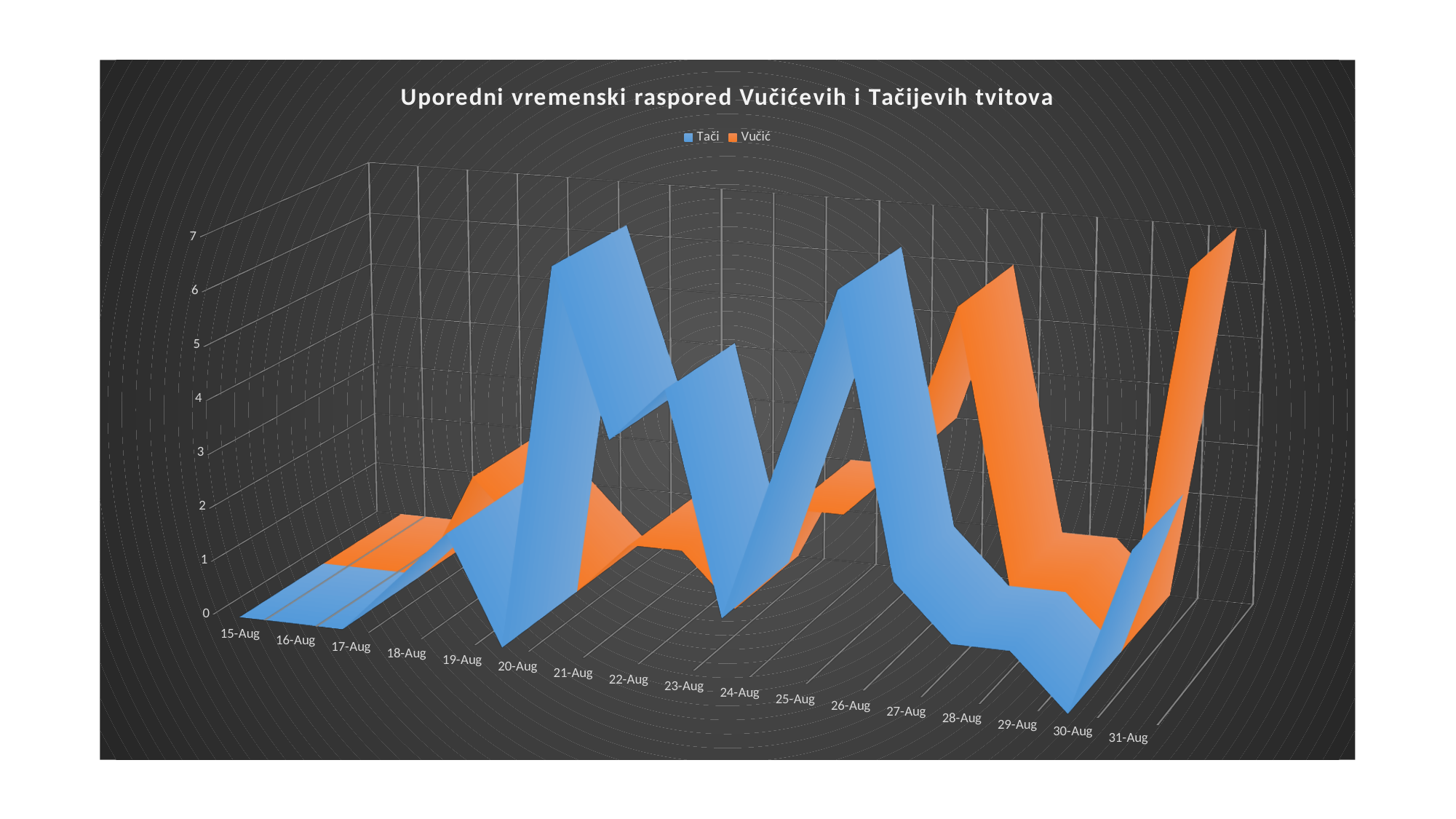
On which date does the Vučić series reach its highest value? 31-Aug Which series is shown in orange? Vučić How many dates are shown on the x axis? 17 Which series has the higher value on 21-Aug, Tači or Vučić? Tači Which series has the higher value on 31-Aug, Tači or Vučić? Vučić What is the title of the chart? Uporedni vremenski raspored Vučićevih i Tačijevih tvitova Is the value for Vučić on 31-Aug greater or less than 4? greater What kind of chart is shown on the slide? line chart How many series does the legend list? 2 Is the value for Tači on 21-Aug greater or less than 4? greater Is the value for Tači on 20-Aug greater or less than 1? less